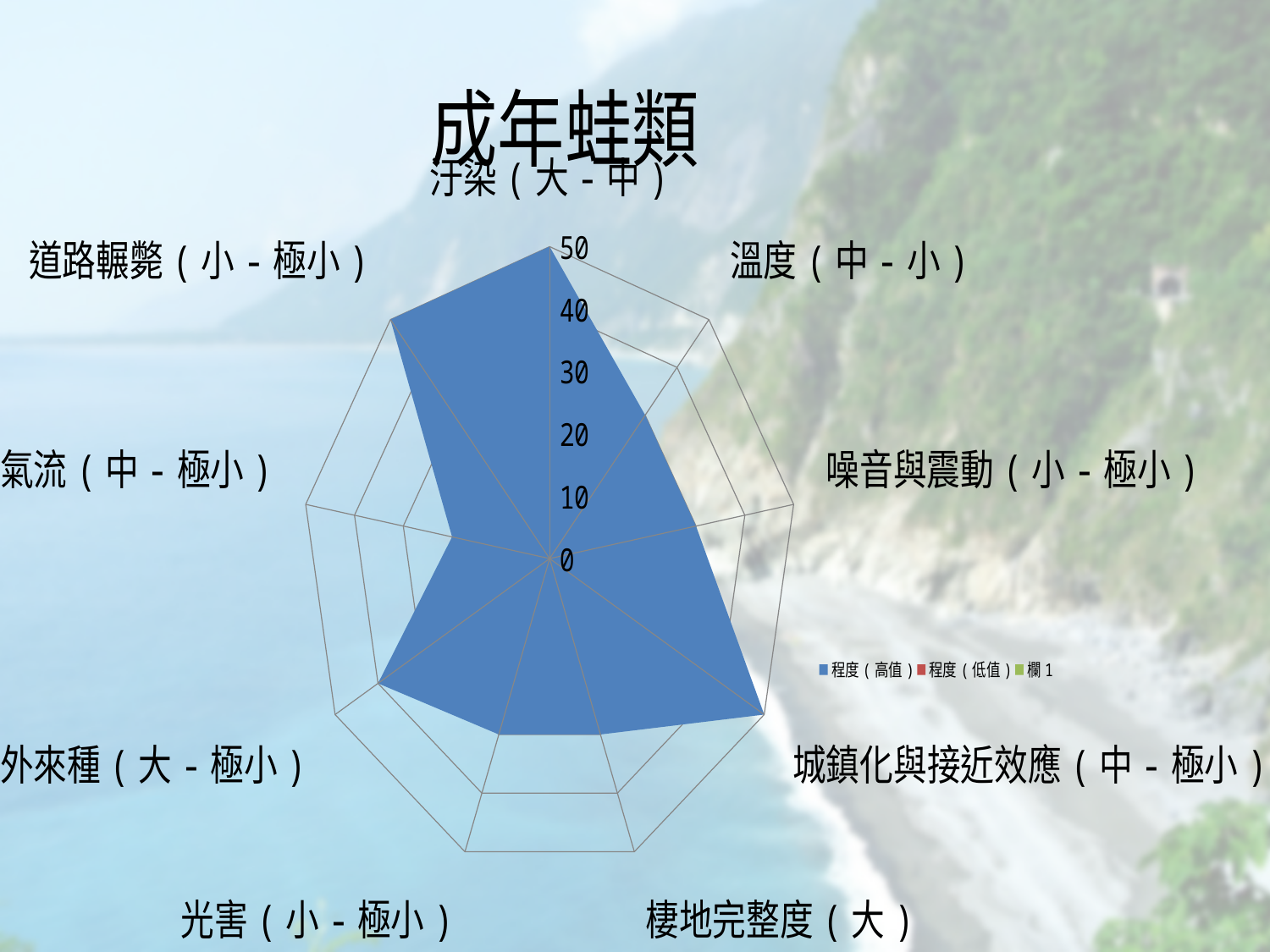
Is the value for 噪音與震動（小－極小） greater or less than 40? less Is the value for 氣流（中－極小） greater or less than 30? less How many categories (axes) does the radar chart have? 9 Is the value for 外來種（大－極小） greater or less than 20? greater What kind of chart is shown on the slide? radar chart What is the title of the chart? 成年蛙類 How many series does the legend list? 3 What is the highest value shown on the chart's axis scale? 50 Which is larger, the value for 汙染（大－中） or the value for 氣流（中－極小）? 汙染（大－中）